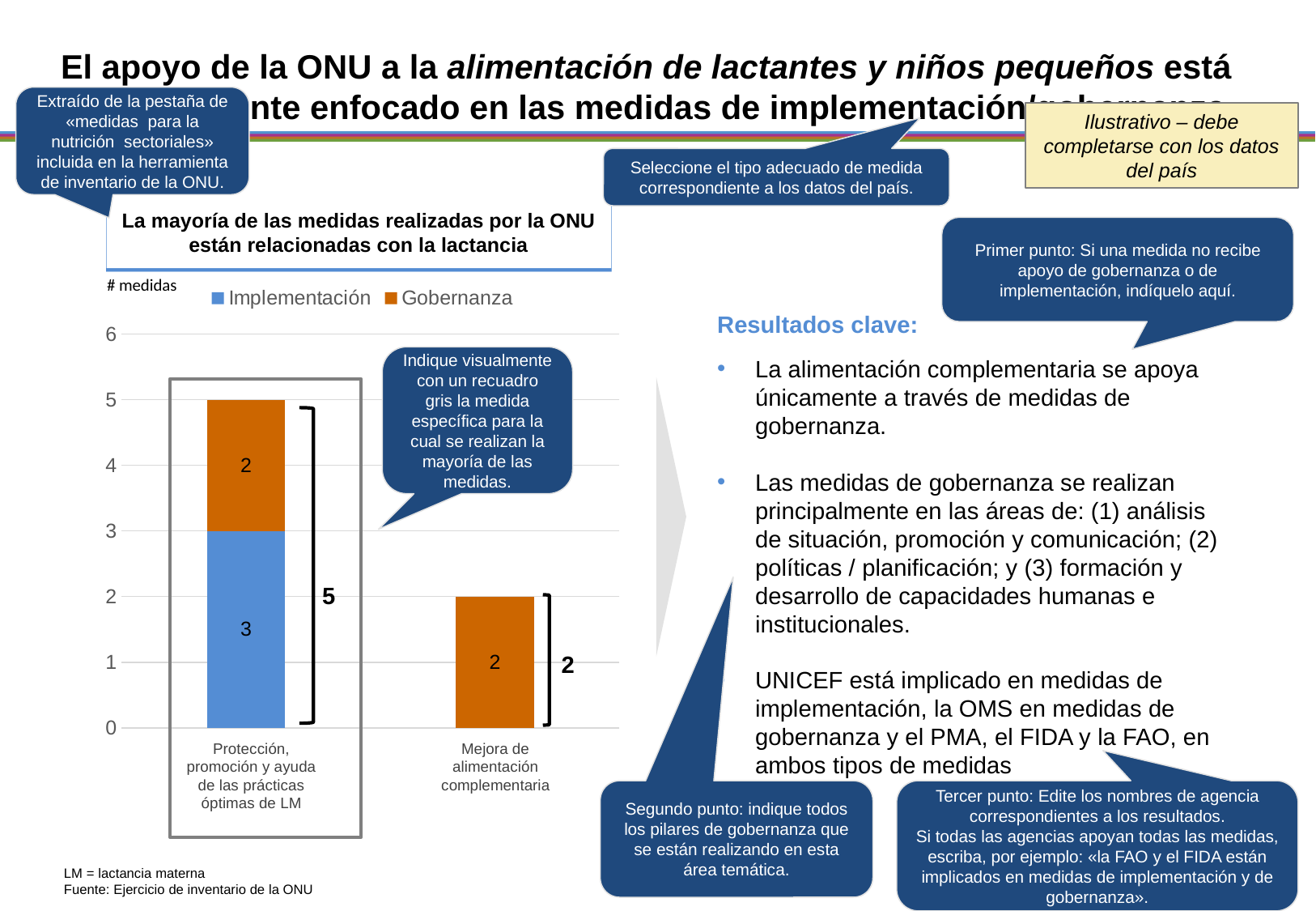
What is the total number of measures for 'Mejora de alimentación complementaria'? 2 What is the title of the chart? La mayoría de las medidas realizadas por la ONU están relacionadas con la lactancia How many series does the chart legend list? 2 What is the Gobernanza value for 'Mejora de alimentación complementaria'? 2 Which series is larger for 'Protección, promoción y ayuda de las prácticas óptimas de LM': Implementación or Gobernanza? Implementación What type of chart is shown on the slide? Stacked bar chart What is the Gobernanza value for 'Protección, promoción y ayuda de las prácticas óptimas de LM'? 2 How many categories are shown on the x axis of the chart? 2 Which category has the highest total number of measures? Protección, promoción y ayuda de las prácticas óptimas de LM What is the Implementación value for 'Protección, promoción y ayuda de las prácticas óptimas de LM'? 3 What is the difference between the total measures for 'Protección, promoción y ayuda de las prácticas óptimas de LM' and 'Mejora de alimentación complementaria'? 3 What is the total number of measures for 'Protección, promoción y ayuda de las prácticas óptimas de LM'? 5